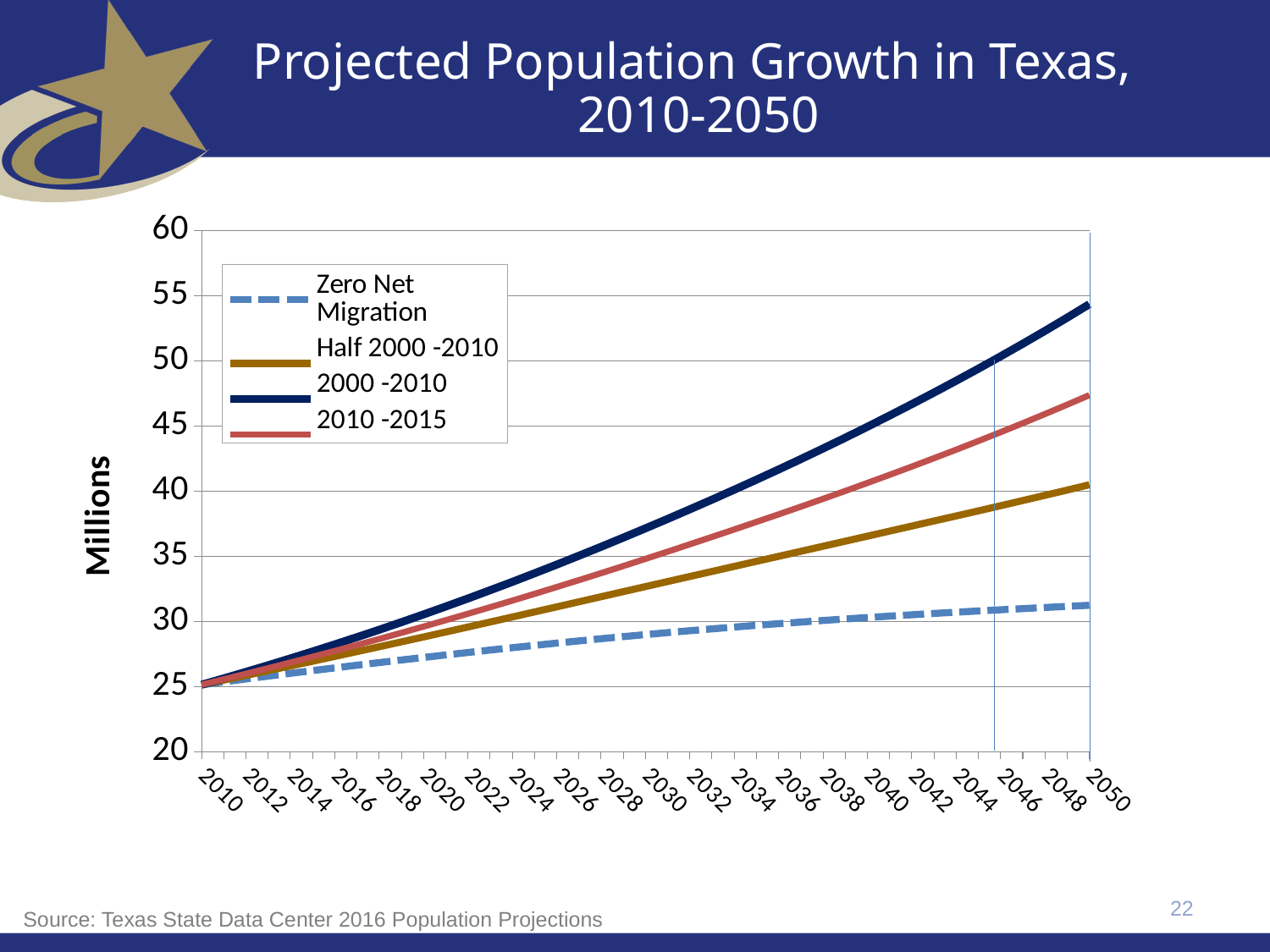
What kind of chart is shown on the slide? Line chart Is the value for the 2010 -2015 series in 2050 greater or less than 45? greater Which series has the lowest projected population in 2050? Zero Net Migration Is the value for the 2000 -2010 series in 2050 greater or less than 50? greater Is the value for the Zero Net Migration series in 2050 greater or less than 35? less In 2050, which series is larger: 2000 -2010 or 2010 -2015? 2000 -2010 Do the values for the 2000 -2010 series rise or fall from 2010 to 2050? Rise In 2050, which series is larger: Half 2000 -2010 or Zero Net Migration? Half 2000 -2010 What is the label on the vertical axis? Millions How many series does the legend list? 4 Which series has the highest projected population in 2050? 2000 -2010 What is the title of the chart? Projected Population Growth in Texas, 2010-2050